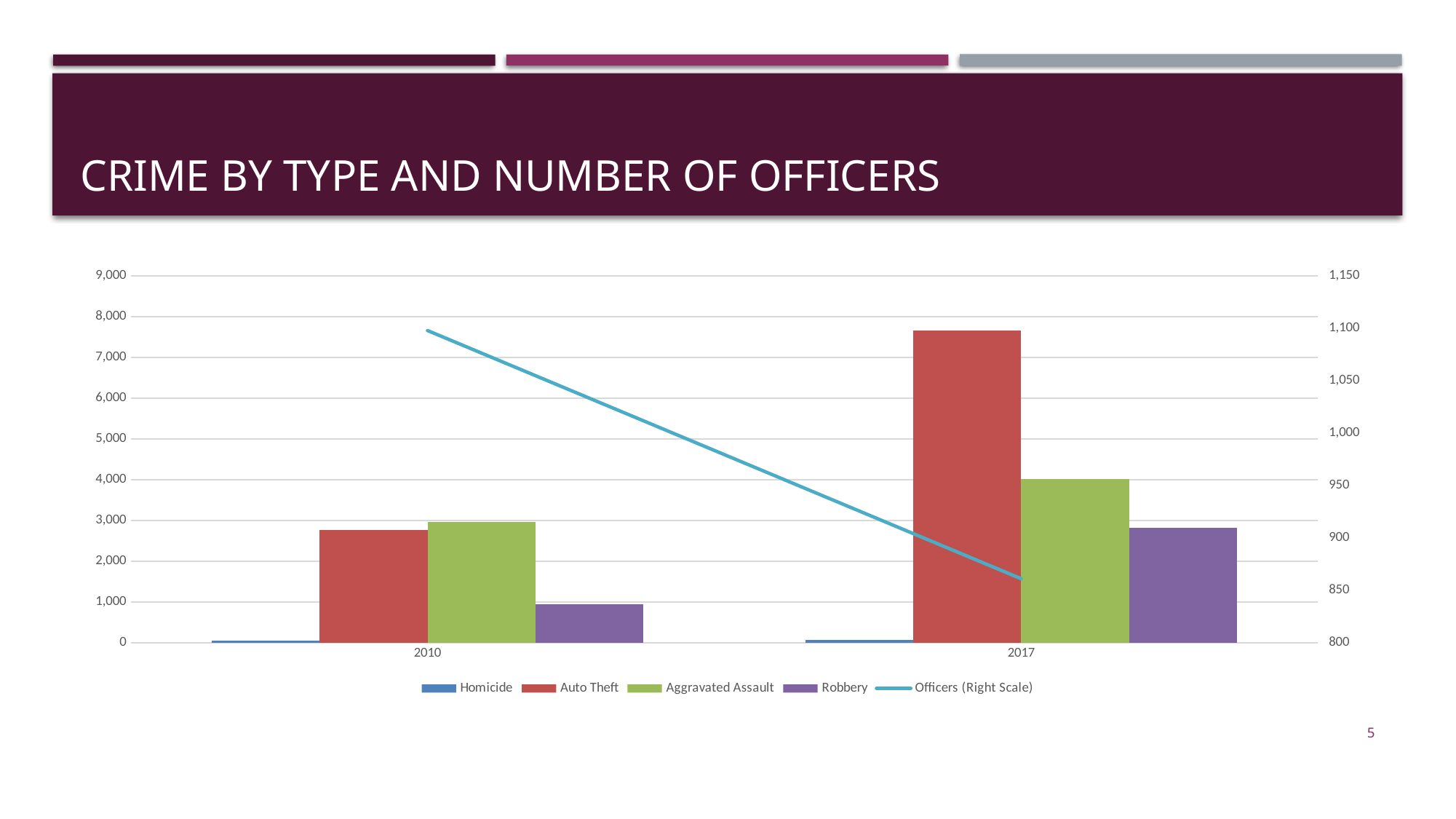
Is the value for Auto Theft in 2017 greater or less than 7,000? greater Which crime type has the tallest bar in 2017? Auto Theft Does the Officers line rise or fall from 2010 to 2017? Fall Which series is plotted on the right scale? Officers (Right Scale) How many series does the legend list? 5 How many years are shown on the x axis? 2 Is the value for Auto Theft in 2010 greater or less than 3,000? less Is the value for Robbery in 2017 greater or less than 3,000? less Which crime type has the lowest bar in 2010? Homicide What kind of chart is shown on the slide? Bar chart with a line Which is larger in 2017, Auto Theft or Aggravated Assault? Auto Theft